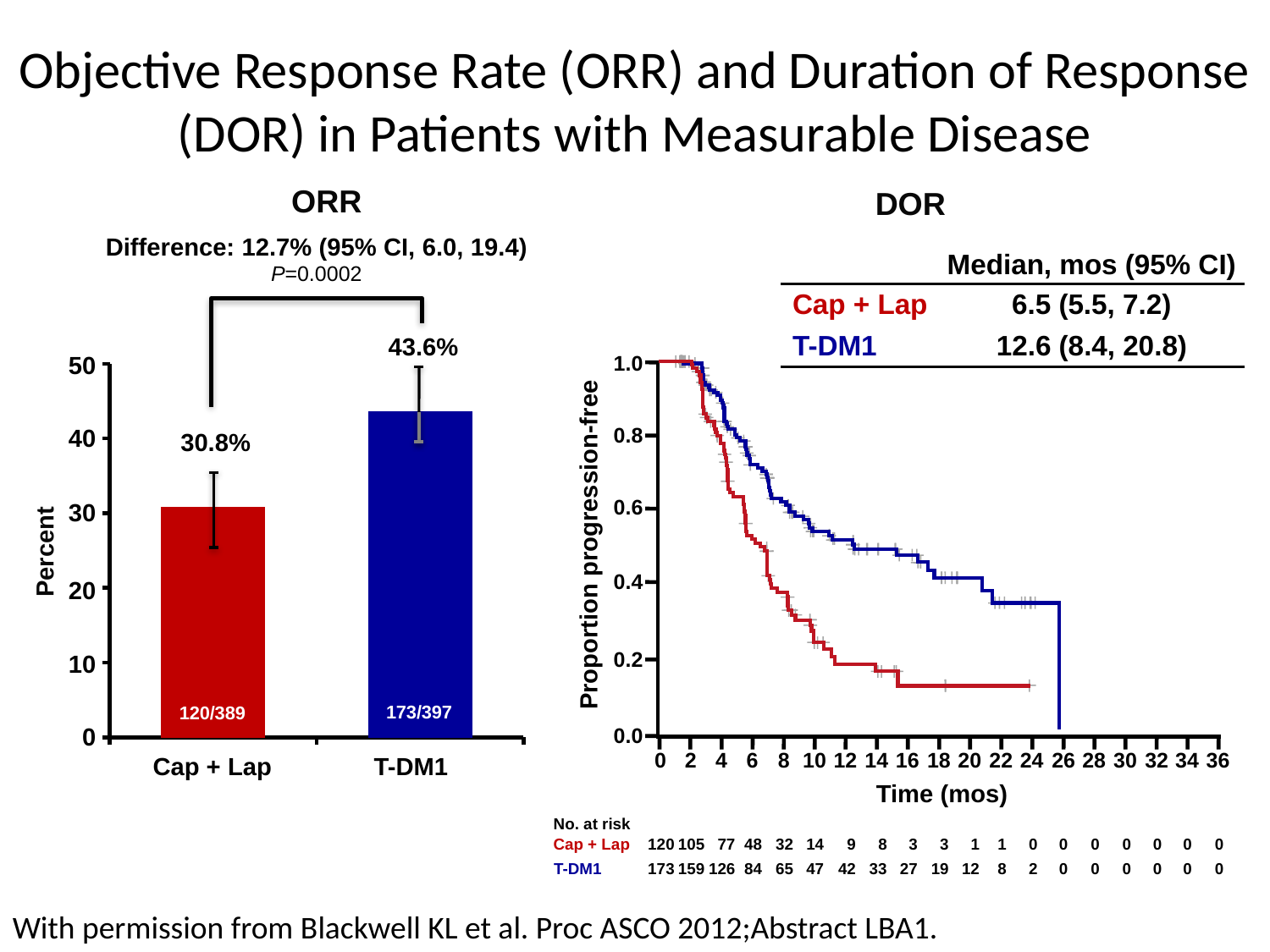
What kind of chart is the ORR chart? Bar chart In the DOR chart, at 10 months is the proportion progression-free for Cap + Lap greater or less than 0.4? less In the ORR chart, how many responders out of how many patients are shown for Cap + Lap? 120/389 In the ORR chart, how many treatment arms are plotted as bars? 2 In the ORR chart, what is the objective response rate for Cap + Lap? 30.8% In the ORR chart, what is the objective response rate for T-DM1? 43.6% In the DOR chart, what is the median duration of response in months for T-DM1? 12.6 (8.4, 20.8) In the ORR chart, which treatment arm has the higher response rate? T-DM1 In the ORR chart, is the value for Cap + Lap greater or less than 40? less In the ORR chart, what is the difference between the T-DM1 and Cap + Lap response rates? 12.7% In the DOR chart, do the curves rise or fall as time increases? fall In the DOR chart, what is the median duration of response in months for Cap + Lap? 6.5 (5.5, 7.2)